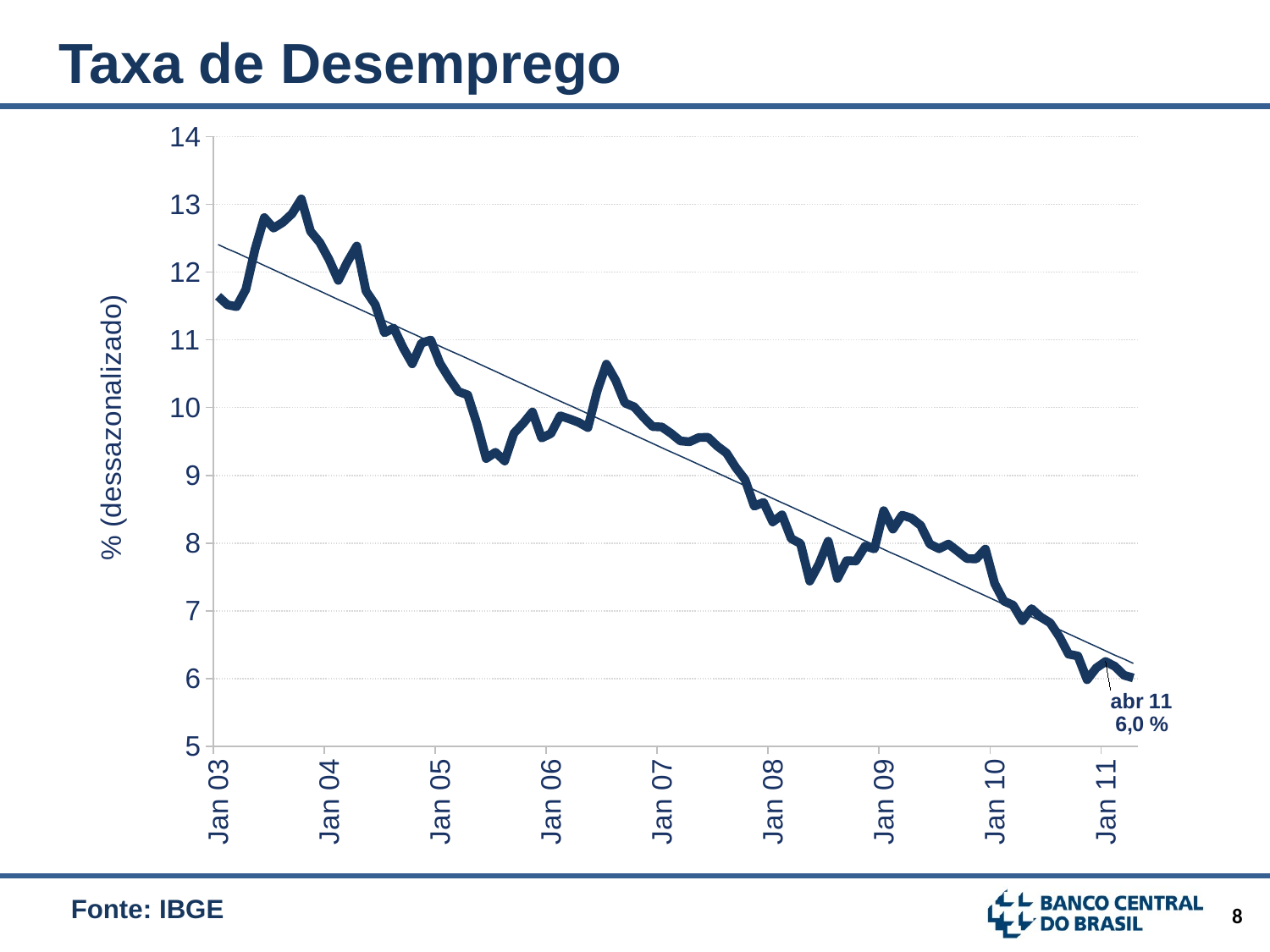
Is the value at Jan 08 greater or less than 9? less Is the value at Jan 06 greater or less than 10? less In which year does the line reach its highest point? 2003 What is the label of the y axis? % (dessazonalizado) Is the value at Jan 07 greater or less than 10? less What kind of chart is shown on the slide? line chart How many year labels are shown on the x axis? 9 What is the title of the chart? Taxa de Desemprego What is the unemployment rate value labelled for abr 11? 6,0 % Does the unemployment rate generally rise or fall from Jan 03 to Jan 11? fall